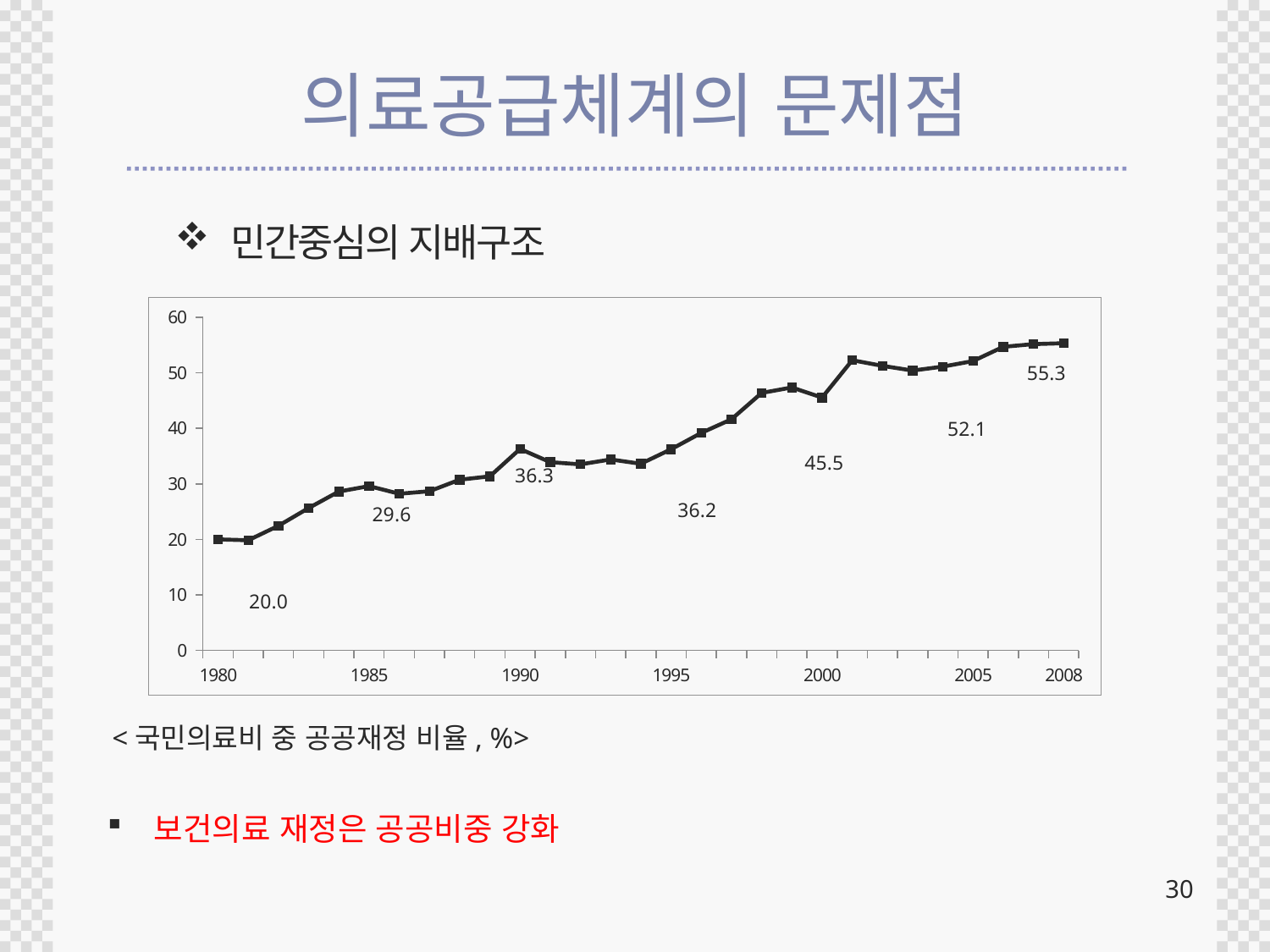
Which year has the highest value? 2008 What is the difference between the values for 2008 and 1980? 35.3 What is the value for 1990? 36.3 What is the value for 2000? 45.5 What is the value for 1985? 29.6 What is the value for 2008? 55.3 Is the value for 1998 greater or less than 40? greater What kind of chart is shown on the slide? line chart What is the value for 1980? 20.0 Which is larger, the value for 2000 or the value for 2005? 2005 Do the values generally rise or fall from 1980 to 2008? rise What is the difference between the values for 2005 and 2000? 6.6